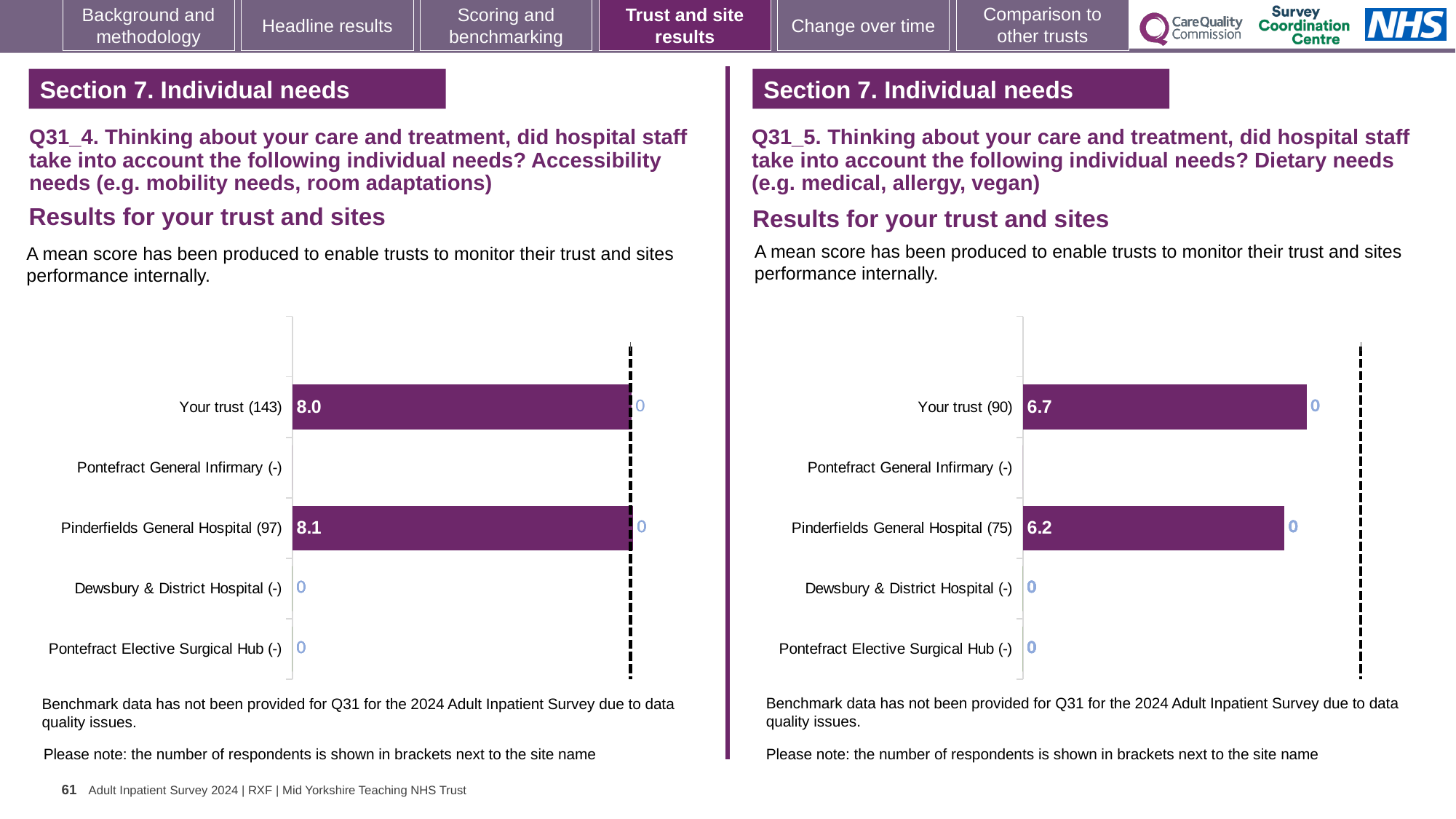
In the right chart (Q31_5, dietary needs), what is the difference between the mean score for Your trust (90) and Pinderfields General Hospital (75)? 0.5 In the right chart (Q31_5, dietary needs), what is the mean score for Your trust (90)? 6.7 In the left chart (Q31_4, accessibility needs), what is the mean score for Your trust (143)? 8.0 In the right chart (Q31_5, dietary needs), how many respondents are shown in brackets for Pinderfields General Hospital? 75 Which chart on the slide has the higher mean score for Your trust: the left chart (Q31_4) or the right chart (Q31_5)? The left chart (Q31_4) In the left chart (Q31_4, accessibility needs), how many respondents are shown in brackets for Your trust? 143 In the right chart (Q31_5, dietary needs), which has the higher mean score: Your trust (90) or Pinderfields General Hospital (75)? Your trust (90) What type of chart is used in the right chart (Q31_5, dietary needs)? Bar chart In the left chart (Q31_4, accessibility needs), what is the difference between the mean score for Pinderfields General Hospital (97) and Your trust (143)? 0.1 In the right chart (Q31_5, dietary needs), what is the mean score for Pinderfields General Hospital (75)? 6.2 In the left chart (Q31_4, accessibility needs), what is the mean score for Pinderfields General Hospital (97)? 8.1 How many categories are listed on the vertical axis of the left chart (Q31_4, accessibility needs)? 5